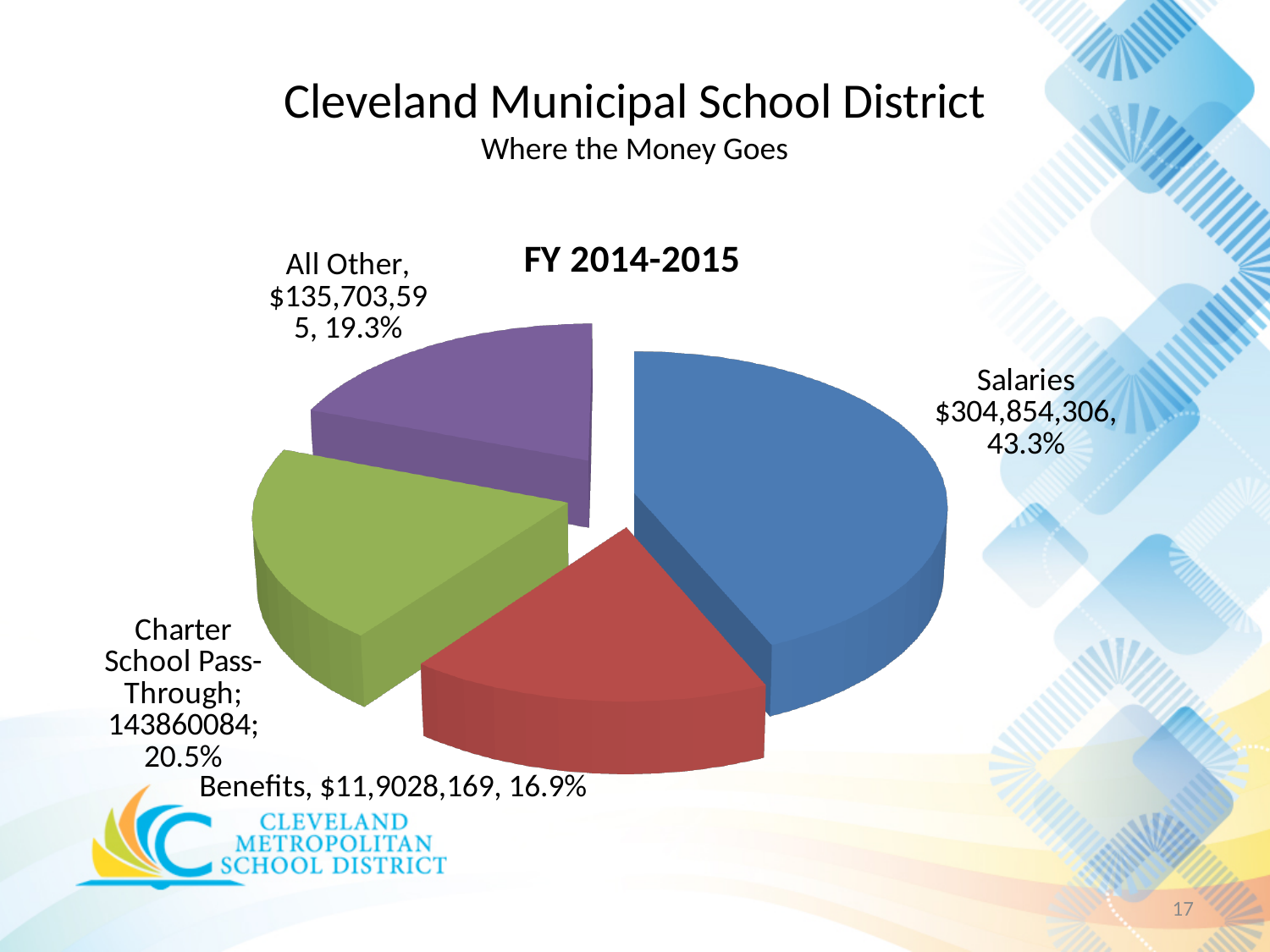
What is the title of the pie chart? FY 2014-2015 What kind of chart is shown on the slide? Pie chart What dollar amount is shown for Salaries? $304,854,306 What percentage of the pie does Charter School Pass-Through represent? 20.5% By how many percentage points does the Salaries share exceed the Benefits share? 26.4 percentage points Which has a larger share of the pie, All Other or Charter School Pass-Through? Charter School Pass-Through What percentage of the pie does Benefits represent? 16.9% Which category has the smallest share of the pie? Benefits What percentage of the pie does Salaries represent? 43.3% How many slices does the pie chart have? 4 Which category has the largest share of the pie? Salaries What percentage of the pie does All Other represent? 19.3%